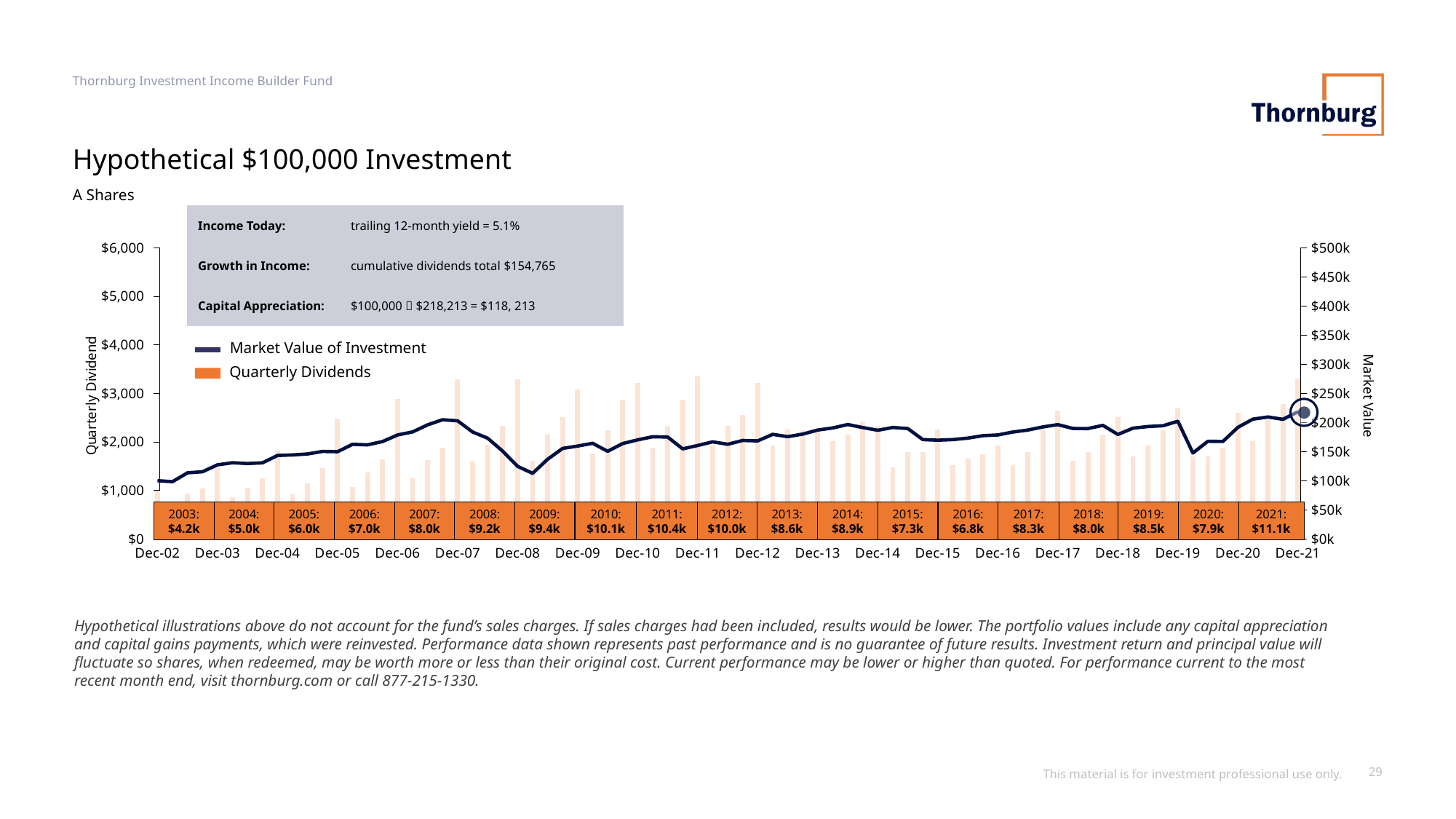
What is the annual dividend total shown for 2021? $11.1k What kind of chart is shown on the slide? Combined line and bar chart How many annual dividend totals are shown in the orange boxes along the bottom of the chart? 19 Which year has the larger annual dividend total, 2011 or 2012? 2011 Which year has the lowest annual dividend total shown in the orange boxes? 2003 How many series does the chart legend list? 2 Is the Market Value of Investment at Dec-08 greater or less than $150k? less What is the difference between the annual dividend totals for 2021 and 2003? $6.9k What is the annual dividend total shown for 2009? $9.4k Which year has the highest annual dividend total shown in the orange boxes? 2021 Does the Market Value of Investment line generally rise or fall from Dec-02 to Dec-21? Rise Is the Market Value of Investment at Dec-21 greater or less than $200k? greater